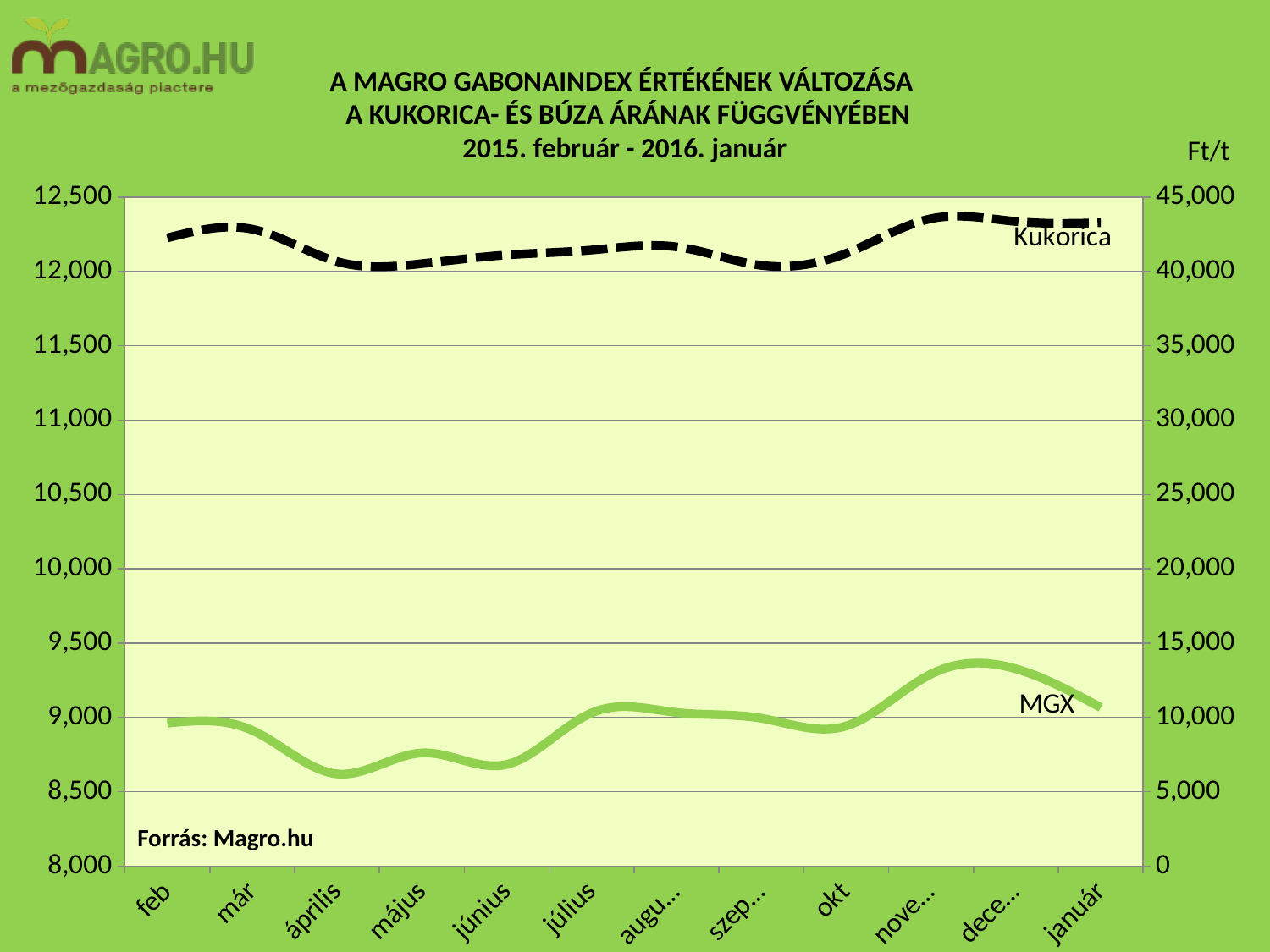
Which month has the highest MGX value? dece... Is the MGX value for dece... greater or less than 9,000 on the left axis? greater Is the MGX value for április greater or less than 9,000 on the left axis? less Is the Kukorica value for május greater or less than 45,000 on the right axis? less Which is larger, the MGX value for feb or for dece...? dece... Does the Kukorica line rise or fall from feb to május? fall What source is cited at the bottom of the chart? Forrás: Magro.hu How many months are plotted along the x axis? 12 What kind of chart is shown on the slide? line chart Does the MGX line rise or fall from okt to dece...? rise How many data series (lines) are plotted on the chart? 2